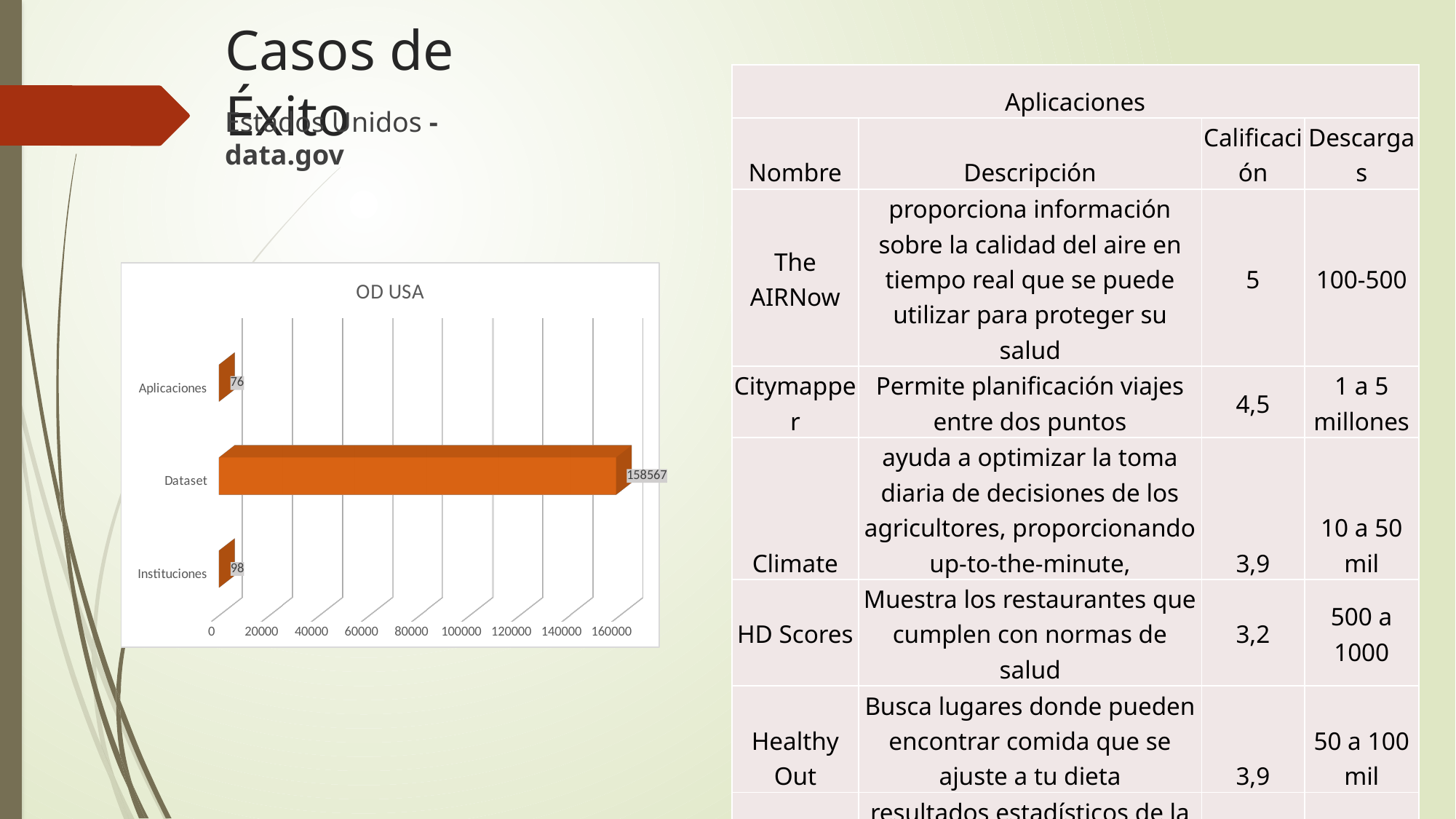
What is the highest tick value shown on the horizontal axis of the OD USA chart? 160000 How many categories are shown in the OD USA chart? 3 What is the value for Dataset in the OD USA chart? 158567 Is the value for Dataset in the OD USA chart greater or less than 140000? greater Which category has the highest value in the OD USA chart? Dataset Which category has the lowest value in the OD USA chart? Aplicaciones What is the value for Aplicaciones in the OD USA chart? 76 What kind of chart is the OD USA chart? bar chart What is the value for Instituciones in the OD USA chart? 98 Which is larger in the OD USA chart, the value for Instituciones or the value for Aplicaciones? Instituciones What is the difference between the values for Instituciones and Aplicaciones in the OD USA chart? 22 What is the title of the chart on the slide? OD USA